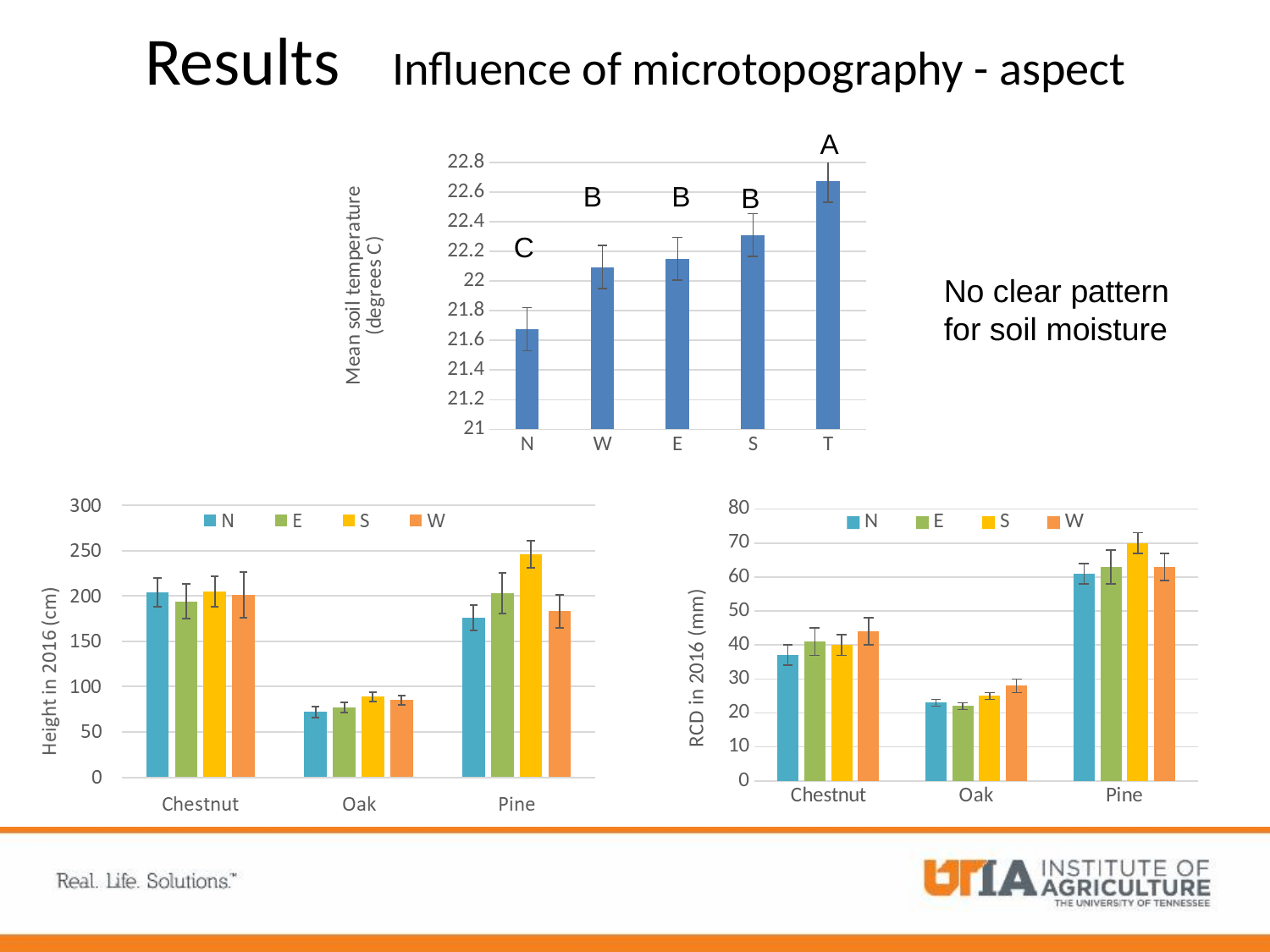
In the top chart of mean soil temperature, is the value for T greater or less than 22.4? greater In the bottom-right chart of RCD in 2016 (mm), is the value for the N series in Oak greater or less than 30? less In the top chart of mean soil temperature, is the value for N greater or less than 22? less In the bottom-left chart of Height in 2016 (cm), which species group has the lowest heights overall? Oak What kind of chart is the bottom-right chart of RCD in 2016 (mm)? Bar chart In the bottom-left chart of Height in 2016 (cm), how many series does the legend list? 4 In the top chart of mean soil temperature, how many aspect categories are shown on the x axis? 5 In the top chart of mean soil temperature, which aspect has the lowest mean soil temperature? N In the top chart of mean soil temperature, which aspect has the highest mean soil temperature? T In the bottom-right chart of RCD in 2016 (mm), which species group has the highest RCD values? Pine